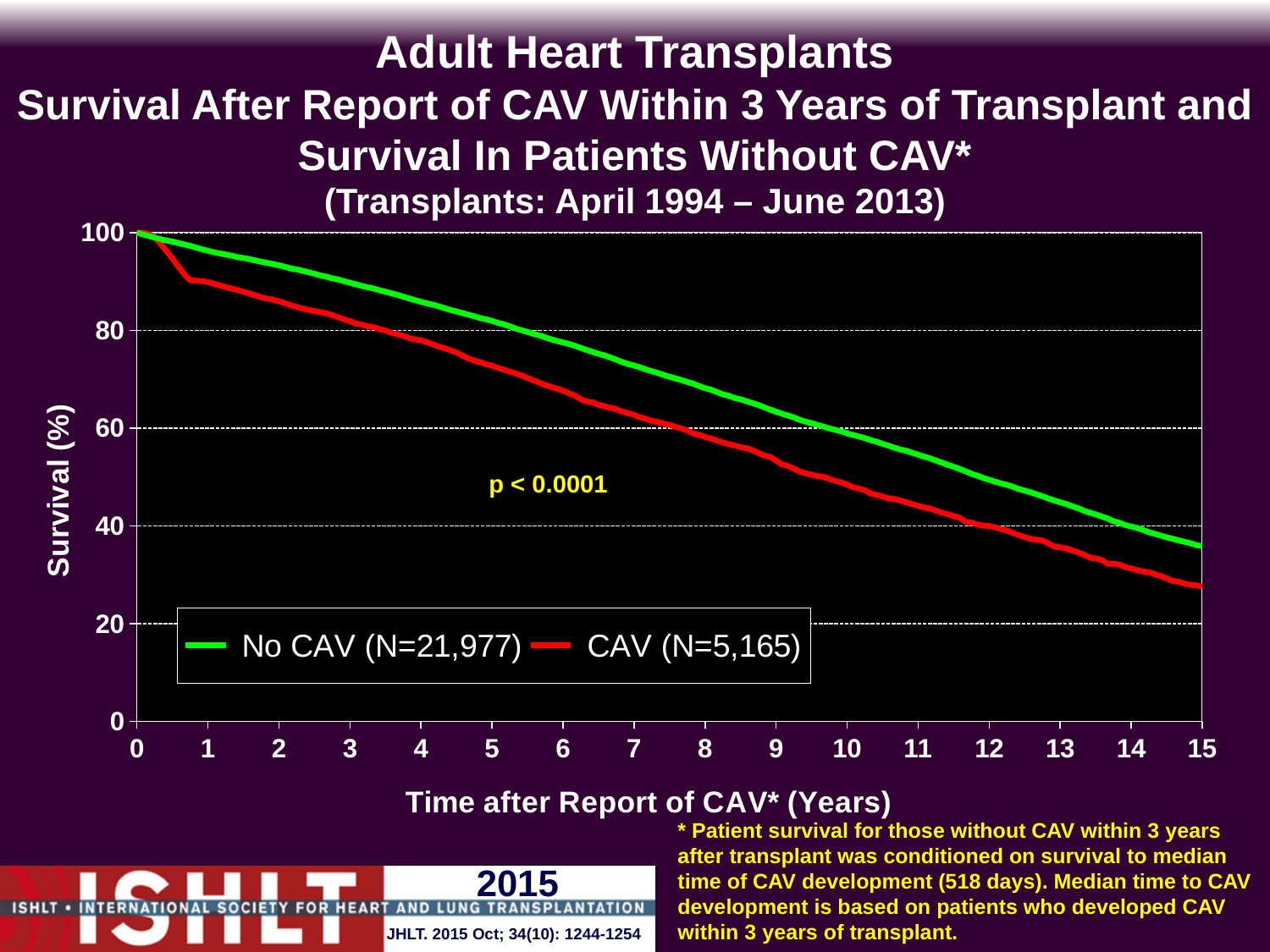
Which series has the higher survival at 10 years, No CAV or CAV? No CAV How many series does the legend list? 2 Is the survival for the CAV group at 10 years greater or less than 60? less What is the N for the No CAV group shown in the legend? 21,977 Is the survival for the CAV group at 15 years greater or less than 40? less Is the survival for the CAV group at 5 years greater or less than 80? less What p-value is printed on the chart? p < 0.0001 Do the survival curves rise or fall as time after report of CAV increases? fall What kind of chart is shown on the slide? line chart